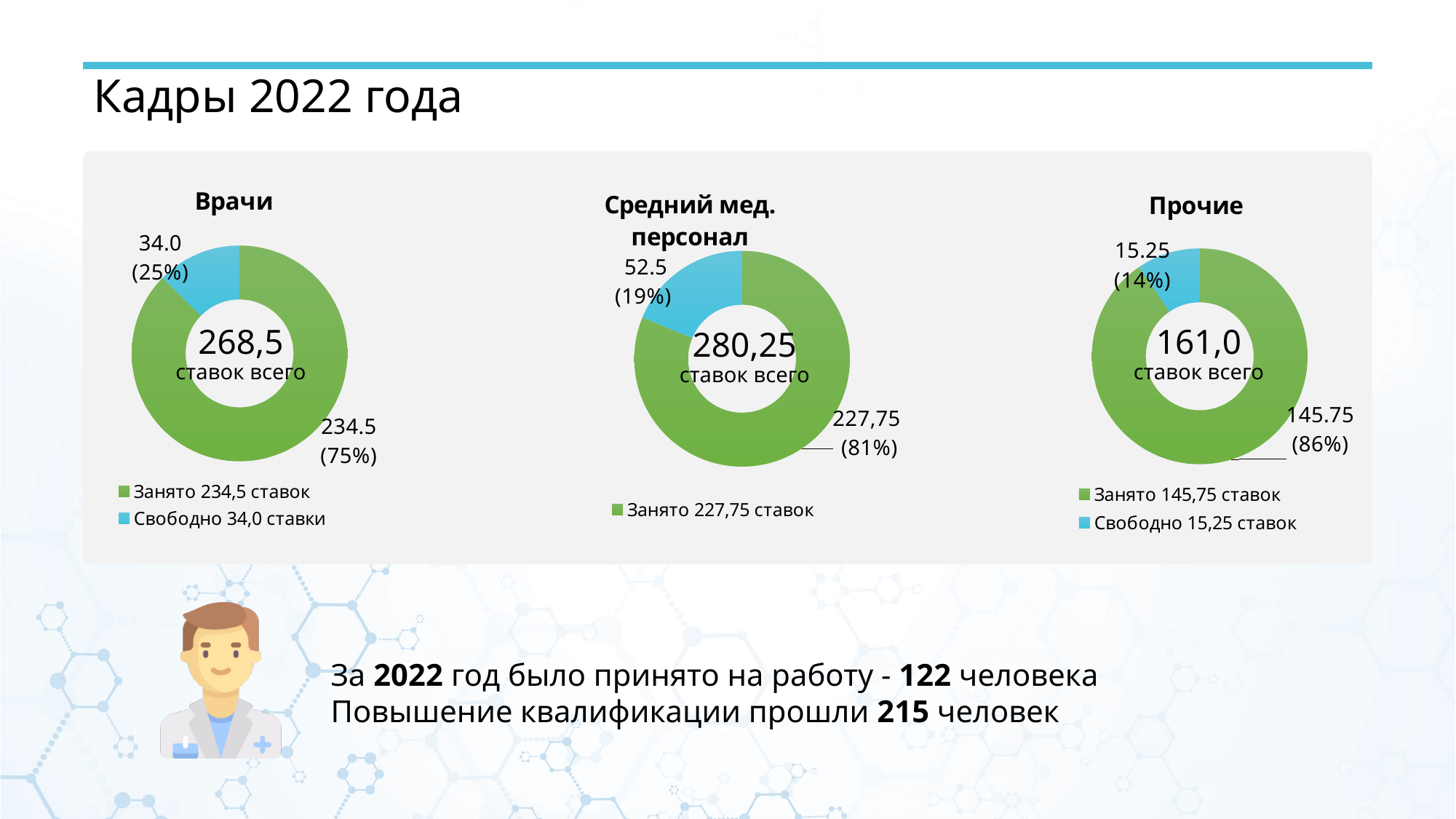
On the 'Врачи' chart, what total number of positions is shown in the centre? 268,5 On the 'Средний мед. персонал' chart, what percentage share does the 'Занято' slice have? 81% Which of the three charts shows the largest total number of positions in its centre? Средний мед. персонал How many entries does the legend of the 'Средний мед. персонал' chart list? 1 On the 'Прочие' chart, what value is shown for the 'Свободно' slice? 15.25 On the 'Врачи' chart, what is the difference between the 'Занято' value and the 'Свободно' value? 200.5 What type of chart is used for 'Прочие'? Pie (donut) chart On the 'Врачи' chart, what value is shown for the green 'Занято' slice? 234.5 On the 'Средний мед. персонал' chart, what value is shown for the blue (free) slice? 52.5 On the 'Врачи' chart, which slice is larger: 'Занято' or 'Свободно'? Занято On the 'Врачи' chart, what percentage share does the 'Свободно' slice have? 25% On the 'Прочие' chart, what percentage share does the 'Занято' slice have? 86%